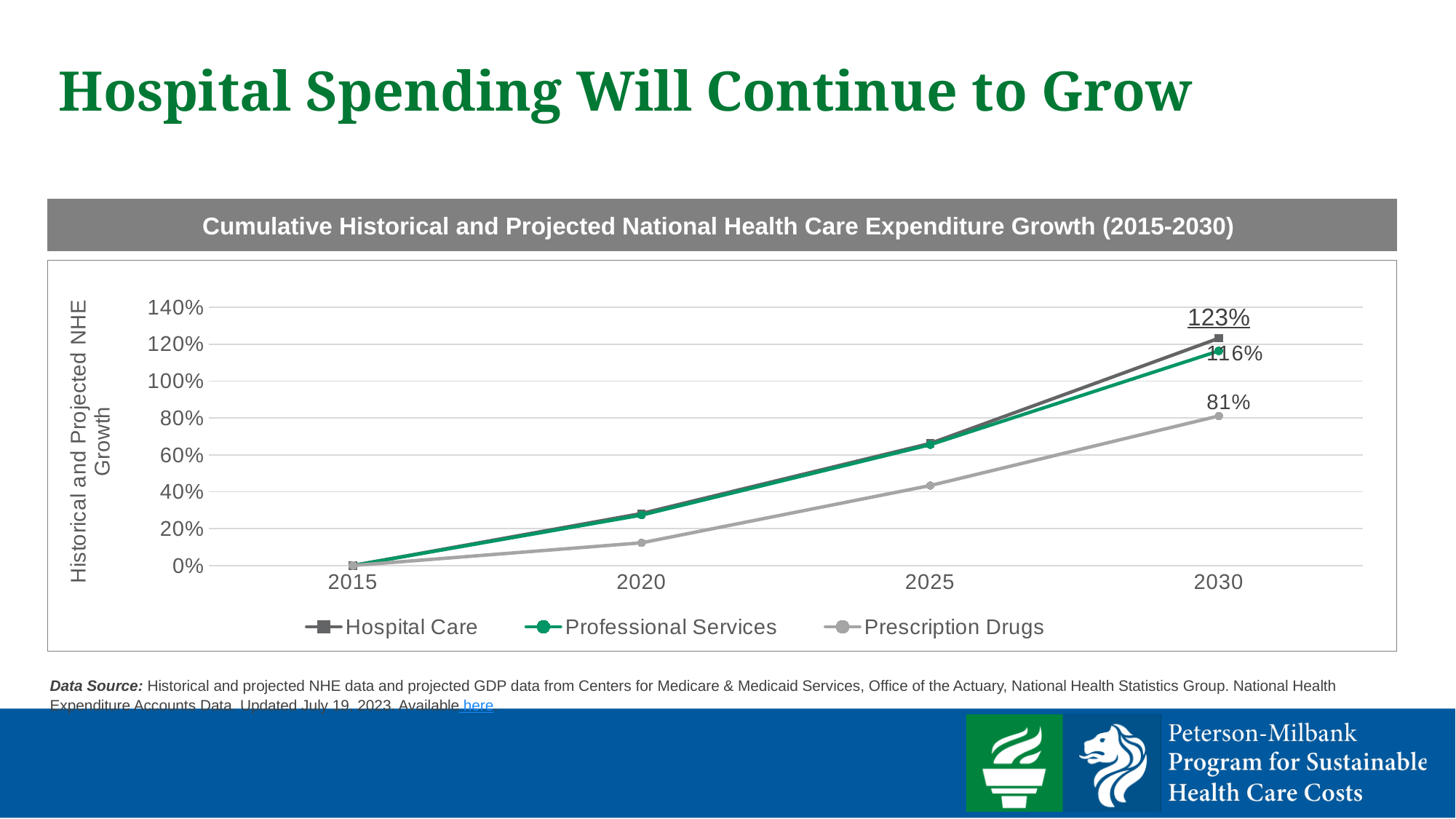
Which series has the highest value in 2030? Hospital Care Do the Hospital Care values rise or fall from 2015 to 2030? Rise What kind of chart is shown? Line chart What is the difference between the Hospital Care and Prescription Drugs values in 2030? 42% Is the value for Hospital Care in 2025 greater or less than 60%? greater What is the value for Hospital Care in 2030? 123% How many series does the legend list? 3 What is the value for Prescription Drugs in 2030? 81% Which series has the lowest value in 2030? Prescription Drugs Is the value for Prescription Drugs in 2025 greater or less than 60%? less What is the value for Professional Services in 2030? 116% Which is larger in 2030, Professional Services or Prescription Drugs? Professional Services